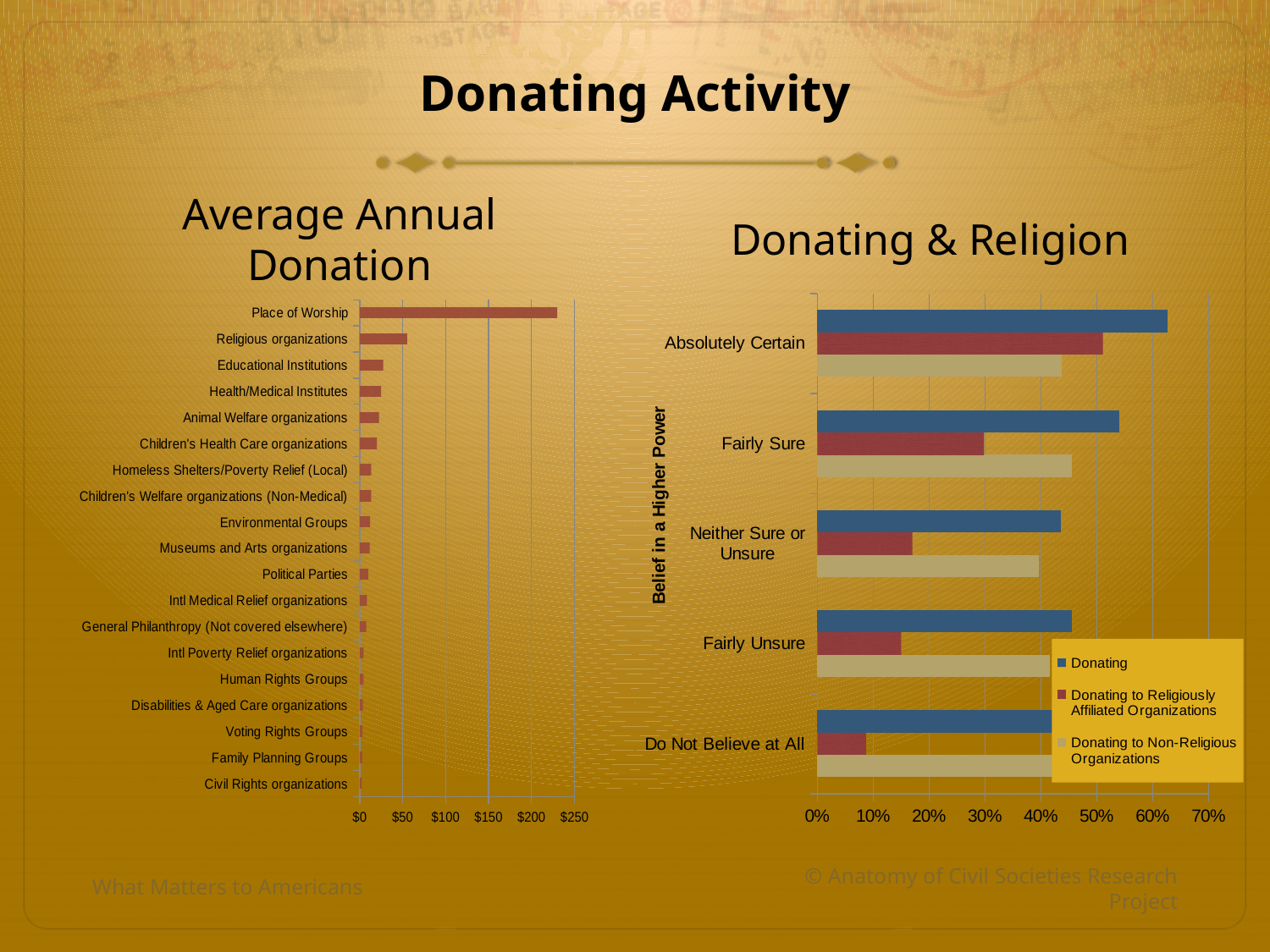
What kind of chart is the Average Annual Donation chart? bar chart On the Average Annual Donation chart, is the value for Educational Institutions greater or less than $50? less On the Average Annual Donation chart, which is larger: the value for Place of Worship or the value for Religious organizations? Place of Worship On the Donating & Religion chart, what is the label of the vertical axis? Belief in a Higher Power On the Average Annual Donation chart, is the value for Place of Worship greater or less than $200? greater On the Donating & Religion chart, is the Donating to Religiously Affiliated Organizations value for Do Not Believe at All greater or less than 10%? less On the Donating & Religion chart, which belief category has the highest Donating value? Absolutely Certain How many categories are shown on the Average Annual Donation chart? 19 On the Donating & Religion chart, which belief category has the lowest value for Donating to Religiously Affiliated Organizations? Do Not Believe at All On the Average Annual Donation chart, which category has the highest value? Place of Worship How many series does the legend of the Donating & Religion chart list? 3